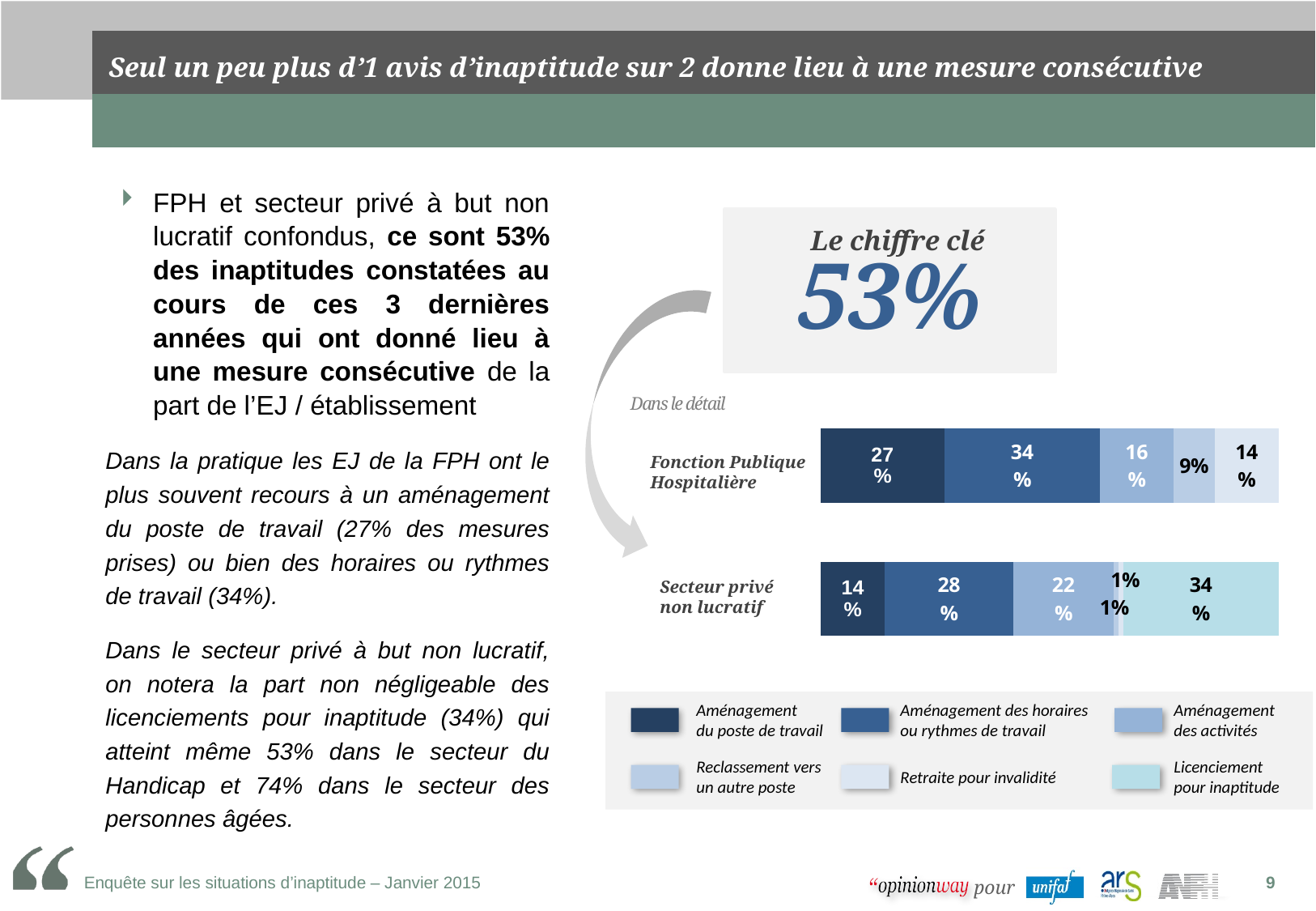
How many series does the legend of the chart list? 6 Which is larger: "Aménagement des horaires ou rythmes de travail" for Fonction Publique Hospitalière or for Secteur privé non lucratif? Fonction Publique Hospitalière What is the value for "Aménagement des horaires ou rythmes de travail" in the Fonction Publique Hospitalière bar? 34% What is the difference between the "Aménagement du poste de travail" values for Fonction Publique Hospitalière and Secteur privé non lucratif? 13% How many categories (bars) does the chart show? 2 Which segment is the largest in the Fonction Publique Hospitalière bar? Aménagement des horaires ou rythmes de travail What key figure is highlighted in the box labelled "Le chiffre clé"? 53% What is the value for "Reclassement vers un autre poste" in the Fonction Publique Hospitalière bar? 9% What is the value for "Aménagement des activités" in the Secteur privé non lucratif bar? 22% What is the value for "Licenciement pour inaptitude" in the Secteur privé non lucratif bar? 34% What is the value for "Aménagement du poste de travail" in the Fonction Publique Hospitalière bar? 27% What kind of chart is shown under "Dans le détail"? stacked bar chart